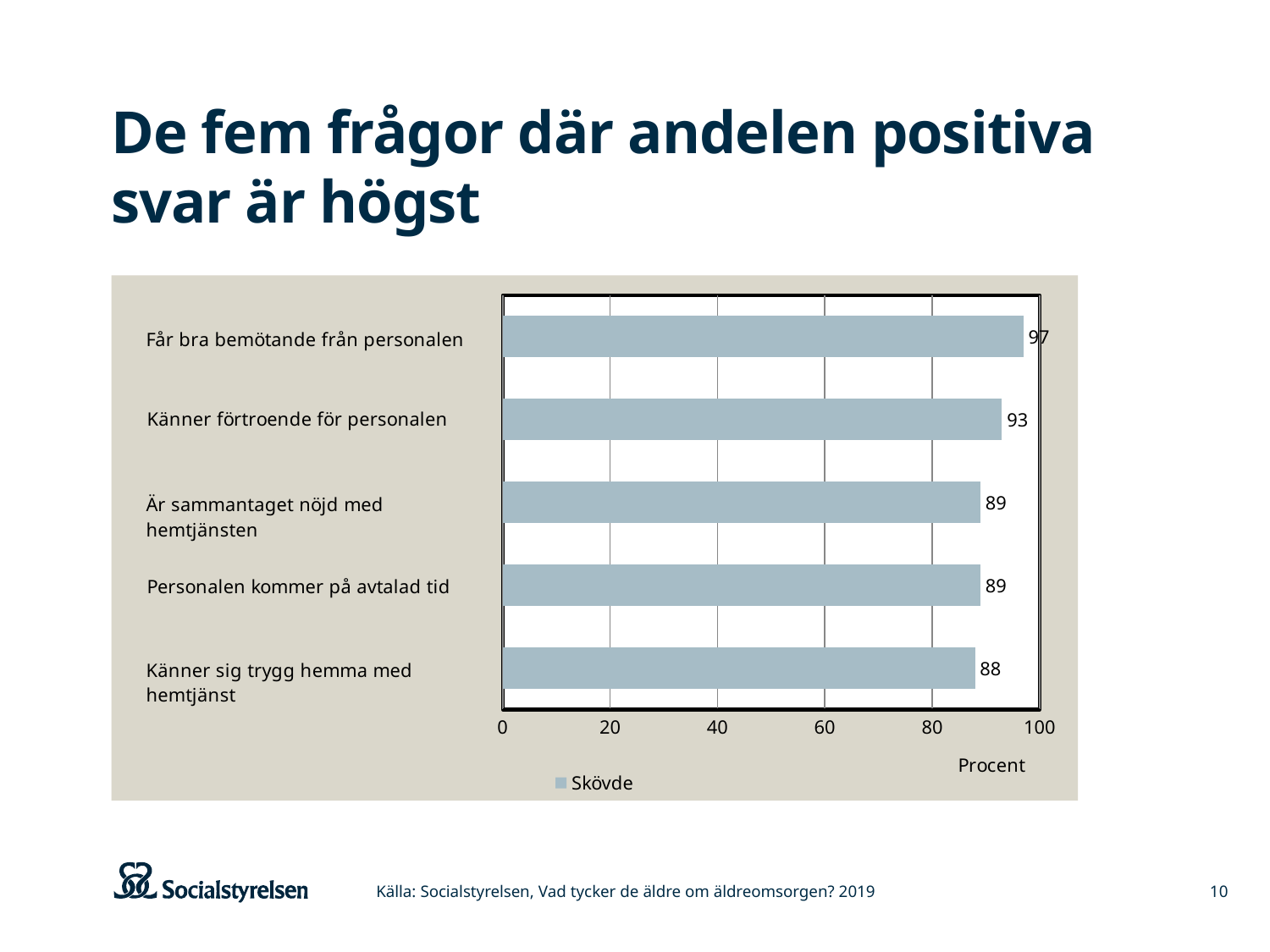
What is the value for "Känner förtroende för personalen"? 93 Is the value for "Känner sig trygg hemma med hemtjänst" greater or less than 80? greater Which category has the lowest value? Känner sig trygg hemma med hemtjänst What kind of chart is shown on the slide? bar chart What is the value for "Får bra bemötande från personalen"? 97 What is the value for "Känner sig trygg hemma med hemtjänst"? 88 How many categories are shown in the chart? 5 What series name does the legend show? Skövde Which category has the highest value? Får bra bemötande från personalen What is the difference between the values for "Får bra bemötande från personalen" and "Känner sig trygg hemma med hemtjänst"? 9 Which is larger, the value for "Känner förtroende för personalen" or the value for "Är sammantaget nöjd med hemtjänsten"? Känner förtroende för personalen What is the value for "Personalen kommer på avtalad tid"? 89